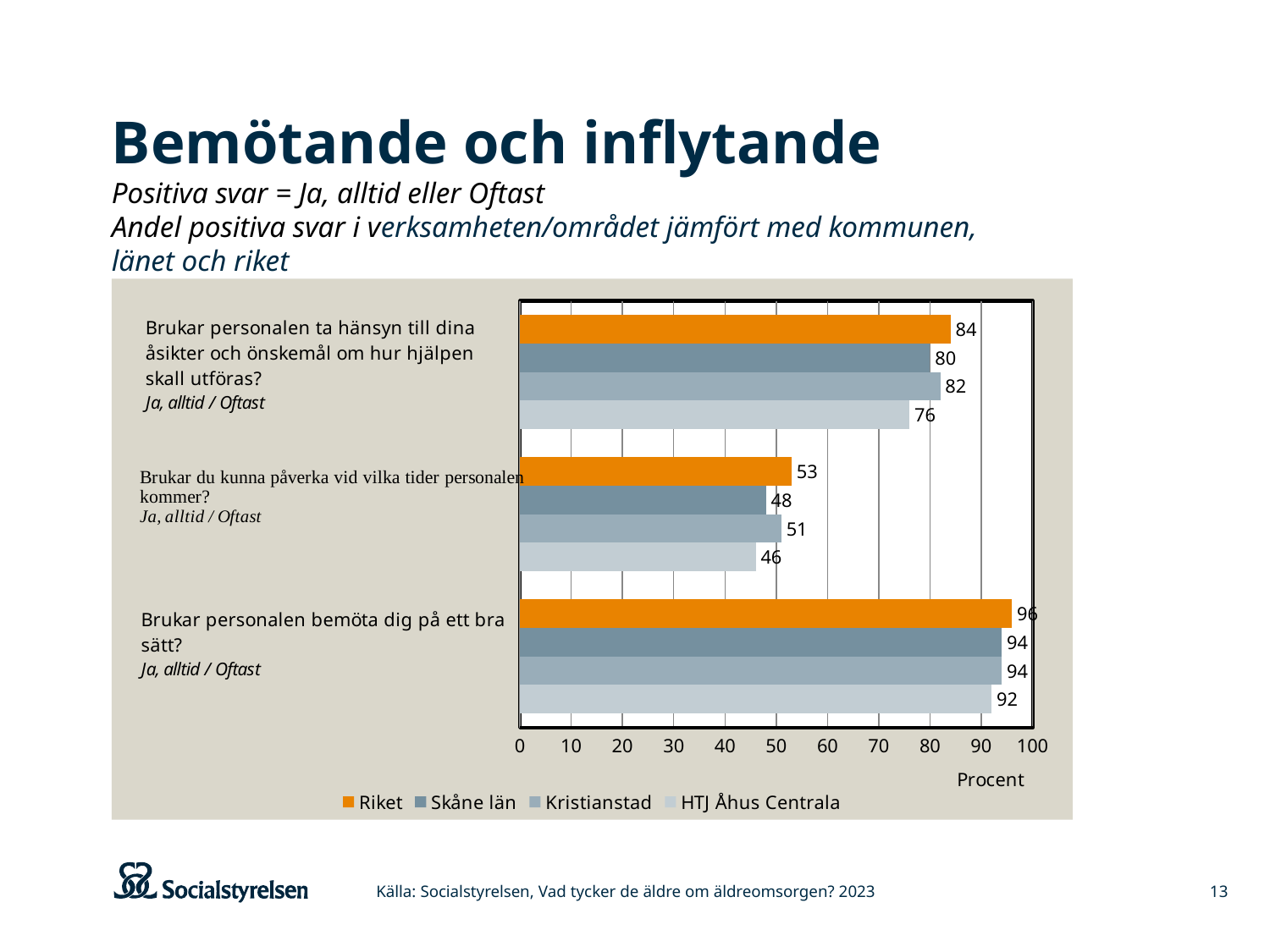
What kind of chart is shown on the slide? Bar chart Which is larger for HTJ Åhus Centrala: the value for "Brukar personalen bemöta dig på ett bra sätt?" or the value for "Brukar du kunna påverka vid vilka tider personalen kommer?"? Brukar personalen bemöta dig på ett bra sätt? How many question categories are shown on the chart? 3 What is the difference between Riket and HTJ Åhus Centrala on the question "Brukar personalen ta hänsyn till dina åsikter och önskemål om hur hjälpen skall utföras?"? 8 What is the value for Skåne län on the question "Brukar du kunna påverka vid vilka tider personalen kommer?"? 48 How many series does the legend list? 4 What is the label of the x axis of the chart? Procent What is the value for Kristianstad on the question "Brukar personalen ta hänsyn till dina åsikter och önskemål om hur hjälpen skall utföras?"? 82 What is the value for Riket on the question "Brukar personalen bemöta dig på ett bra sätt?"? 96 What is the value for HTJ Åhus Centrala on the question "Brukar du kunna påverka vid vilka tider personalen kommer?"? 46 Which series has the lowest value on the question "Brukar personalen ta hänsyn till dina åsikter och önskemål om hur hjälpen skall utföras?"? HTJ Åhus Centrala Which series has the highest value on the question "Brukar du kunna påverka vid vilka tider personalen kommer?"? Riket